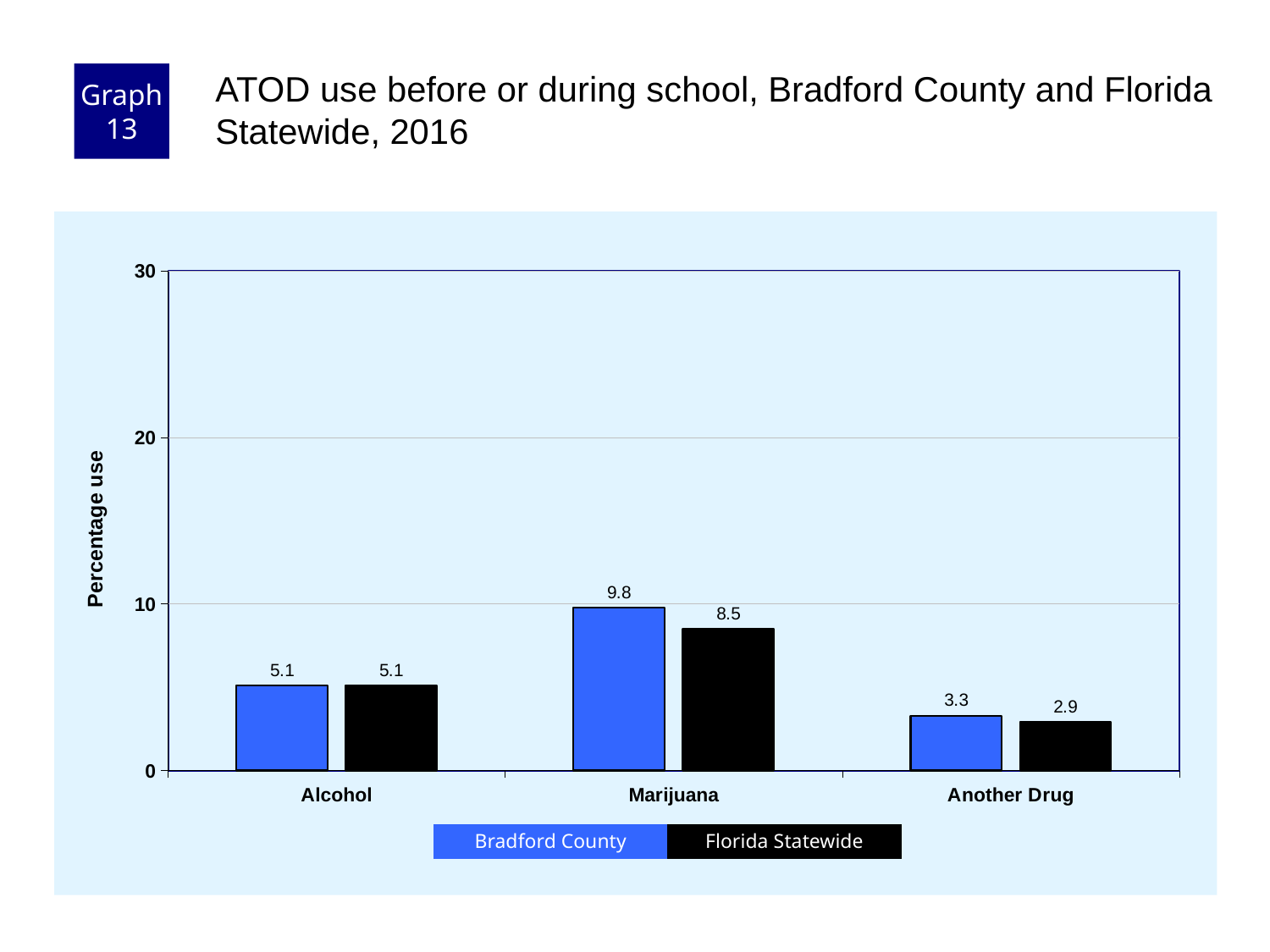
Which is larger for Another Drug, the Bradford County value or the Florida Statewide value? Bradford County What kind of chart is shown on the slide? bar chart What is the Florida Statewide value for Alcohol? 5.1 What is the difference between the Bradford County values for Marijuana and Alcohol? 4.7 What is the Bradford County value for Marijuana? 9.8 Which category has the lowest Florida Statewide value? Another Drug Is the Bradford County value for Marijuana greater or less than 10? less What is the difference between the Bradford County and Florida Statewide values for Marijuana? 1.3 How many categories are shown on the x axis? 3 What is the Florida Statewide value for Another Drug? 2.9 Which category has the highest Bradford County value? Marijuana How many series does the legend list? 2